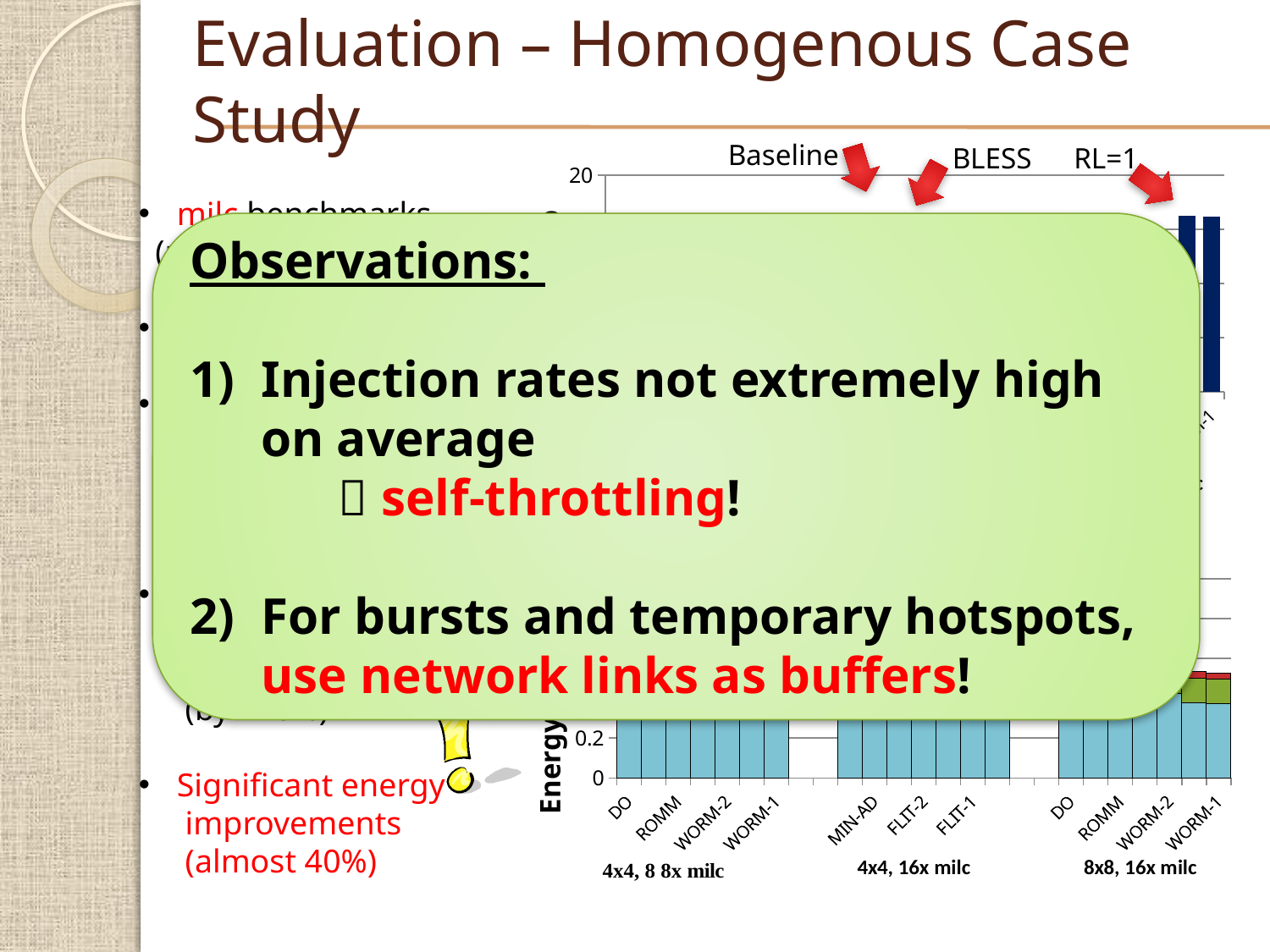
What kind of chart is the bottom chart on the slide (the one with the Energy axis)? bar chart In the bottom chart, is the value for MIN-AD greater or less than 0.2? greater What is the highest tick value visible on the vertical axis of the top chart? 20 In the bottom chart, which group label appears under the categories MIN-AD, FLIT-2 and FLIT-1? 4x4, 16x milc What is the label on the vertical axis of the bottom chart? Energy In the bottom chart, is the value for WORM-1 in the 8x8, 16x milc group greater or less than 0.2? greater In the bottom chart, is the value for FLIT-1 greater or less than 0.2? greater How many benchmark groups (group labels under the x axis) does the bottom chart show? 3 How many category labels are shown along the x axis of the bottom chart? 11